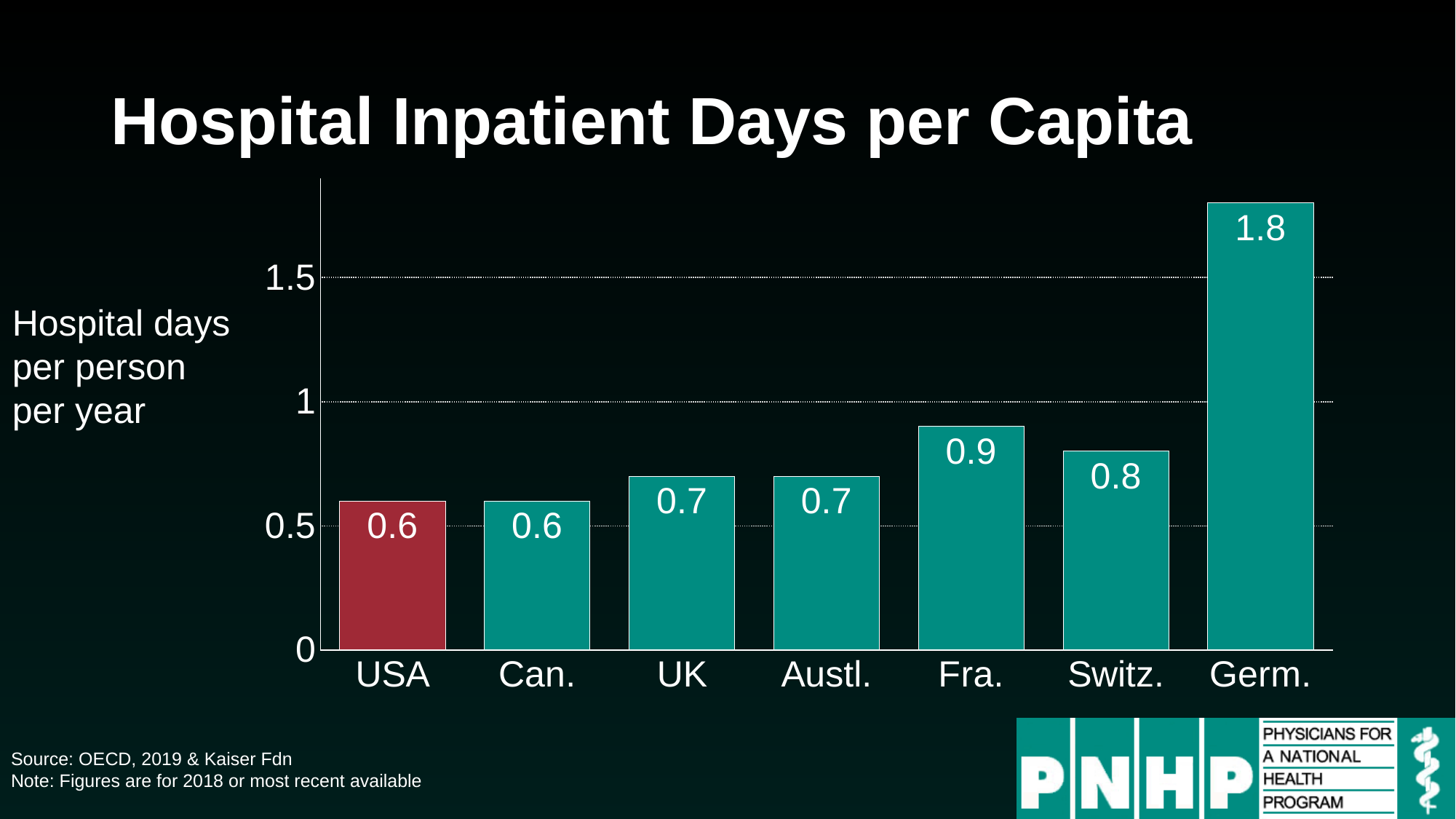
Which bar in the Hospital Inpatient Days per Capita chart is coloured red rather than teal? USA What is the value for Fra. in the Hospital Inpatient Days per Capita chart? 0.9 What kind of chart is shown on the slide? Bar chart Is the value for Germ. greater or less than 1.5 in the Hospital Inpatient Days per Capita chart? greater What is the difference between the values for Germ. and the USA in the Hospital Inpatient Days per Capita chart? 1.2 What is the value for the USA in the Hospital Inpatient Days per Capita chart? 0.6 What is the value for Switz. in the Hospital Inpatient Days per Capita chart? 0.8 Which is larger in the Hospital Inpatient Days per Capita chart, the value for Fra. or the value for UK? Fra. What is the value for Germ. in the Hospital Inpatient Days per Capita chart? 1.8 Which country has the highest value in the Hospital Inpatient Days per Capita chart? Germ. How many countries are shown in the Hospital Inpatient Days per Capita chart? 7 What is the difference between the values for Fra. and Switz. in the Hospital Inpatient Days per Capita chart? 0.1